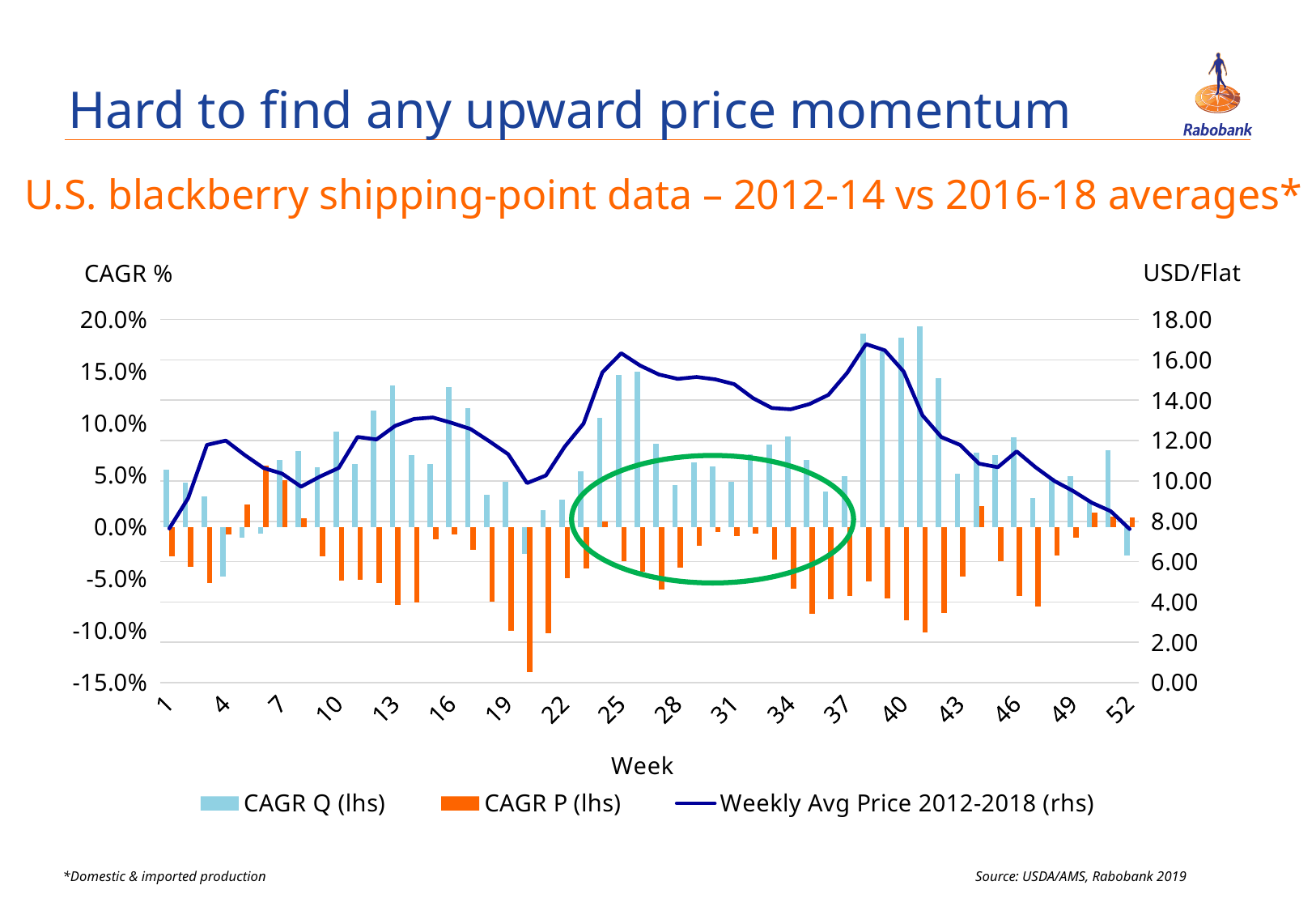
Which week has the lowest CAGR P value? Week 20 How many series does the legend list? 3 What is the title of the chart? U.S. blackberry shipping-point data – 2012-14 vs 2016-18 averages* Is the CAGR P value for week 20 greater or less than -10.0%? less Is the Weekly Avg Price 2012-2018 for week 38 greater or less than 16.00? greater What kind of chart is this? Combined bar and line chart Which is larger, the CAGR Q value for week 41 or for week 1? Week 41 Is the CAGR Q value for week 41 greater or less than 15.0%? greater Does the Weekly Avg Price 2012-2018 line rise or fall from week 38 to week 52? Fall What is the label of the right-hand vertical axis? USD/Flat How many weeks are plotted along the x axis? 52